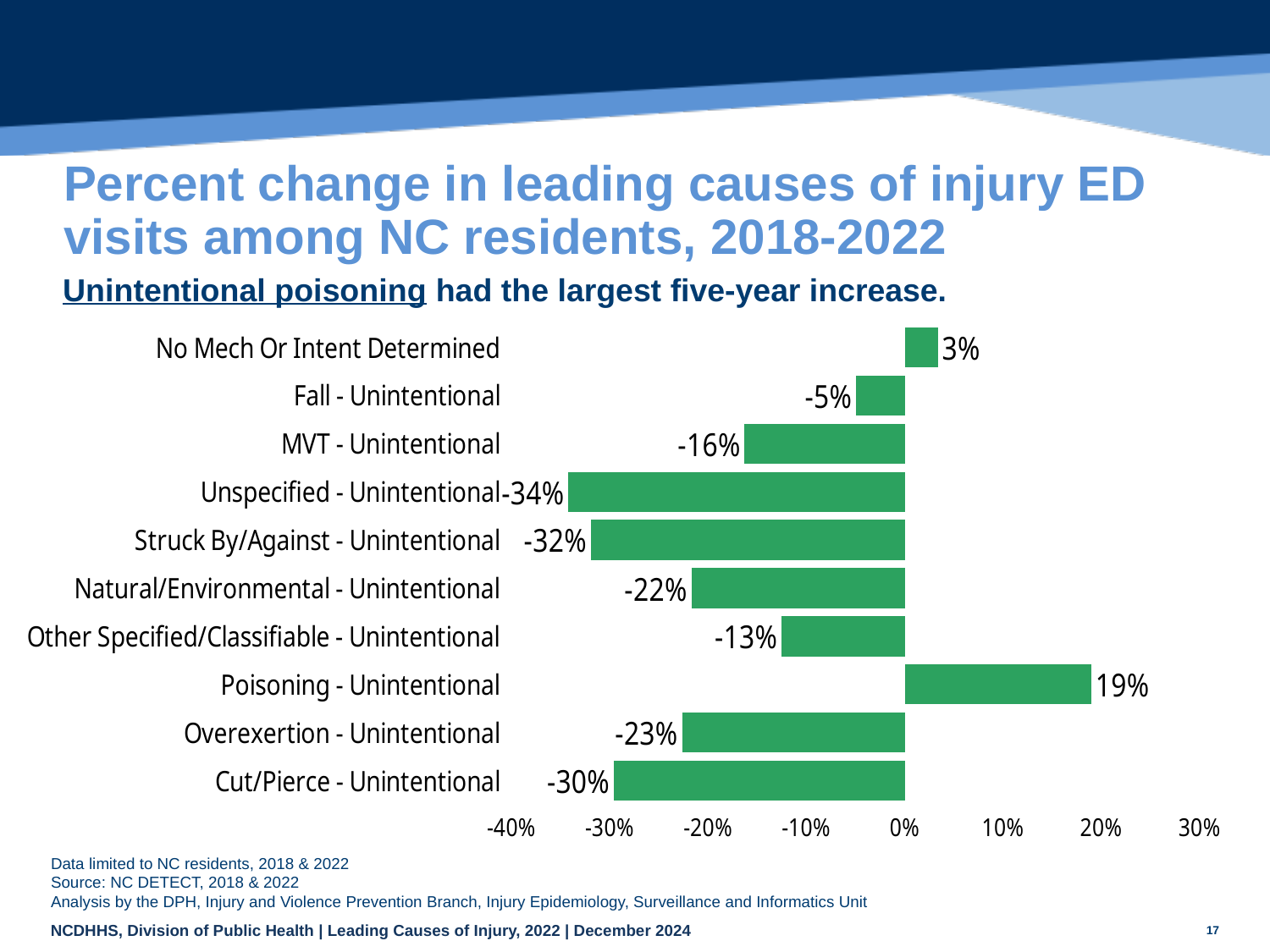
How many categories are shown in the chart? 10 What is the percent change for Cut/Pierce - Unintentional? -30% How many categories show a positive percent change? 2 Which has a larger percent change, MVT - Unintentional or Overexertion - Unintentional? MVT - Unintentional What colour are the bars in the chart? Green Which category has the lowest percent change? Unspecified - Unintentional What is the percent change for Natural/Environmental - Unintentional? -22% Which category has the highest percent change? Poisoning - Unintentional What is the percent change for Fall - Unintentional? -5% What kind of chart is shown on the slide? Bar chart What is the difference between the percent change for Poisoning - Unintentional and No Mech Or Intent Determined? 16 percentage points What is the percent change for Poisoning - Unintentional? 19%